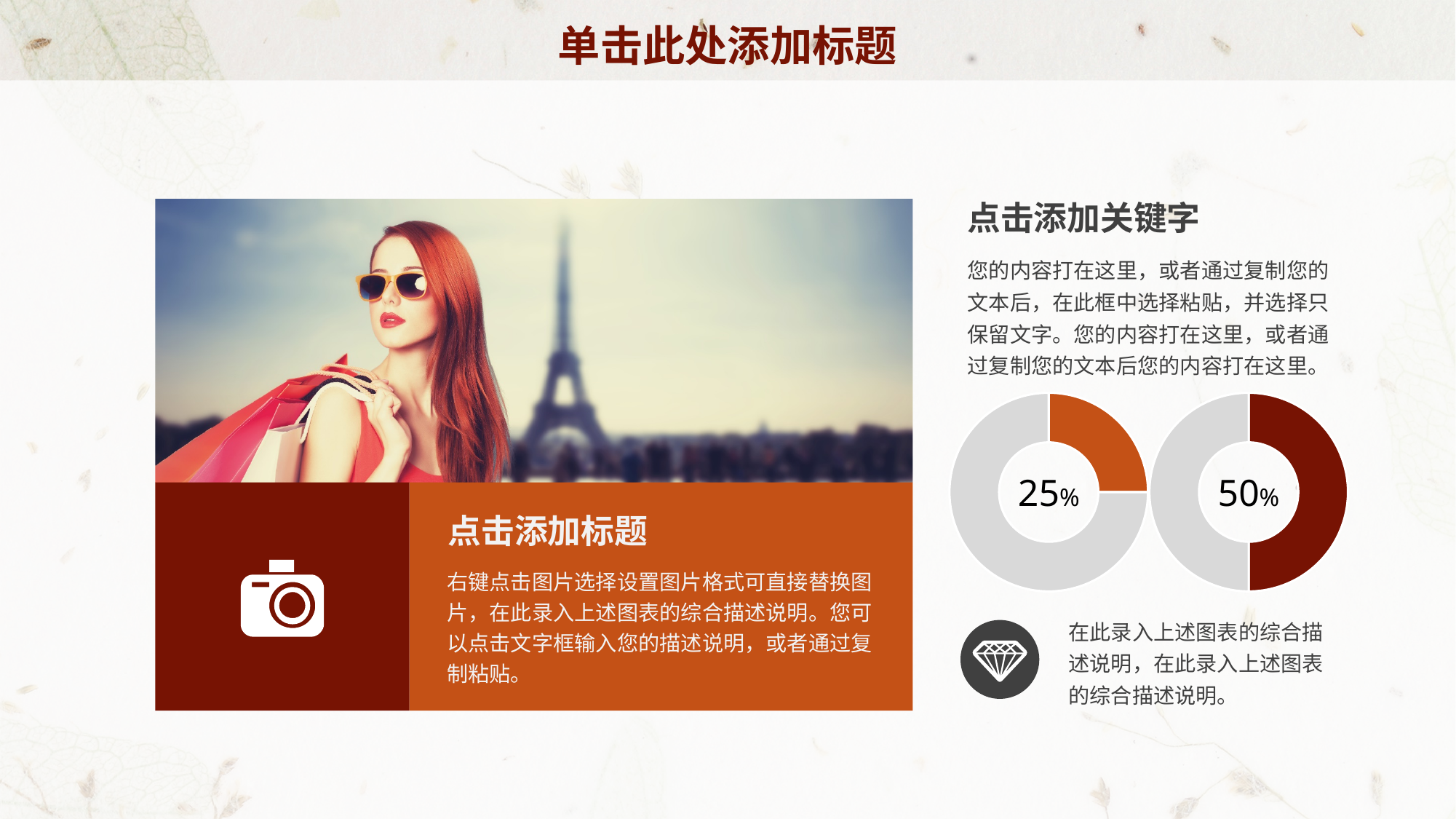
What kind of chart is the right chart on the slide? Donut chart What share of the right donut chart is filled with the dark red colour? 50% Which donut chart shows the larger percentage, the left one or the right one? The right one What value is shown in the centre of the right donut chart? 50% What share of the left donut chart is filled with the orange colour? 25% How many donut charts are on the slide? 2 What kind of chart is the left chart on the slide? Donut chart What is the difference between the percentage in the right donut chart and the percentage in the left donut chart? 25% What colour is the filled segment of the right donut chart? Dark red Is the value shown in the left donut chart greater or less than 50%? less What colour is the filled segment of the left donut chart? Orange What value is shown in the centre of the left donut chart? 25%